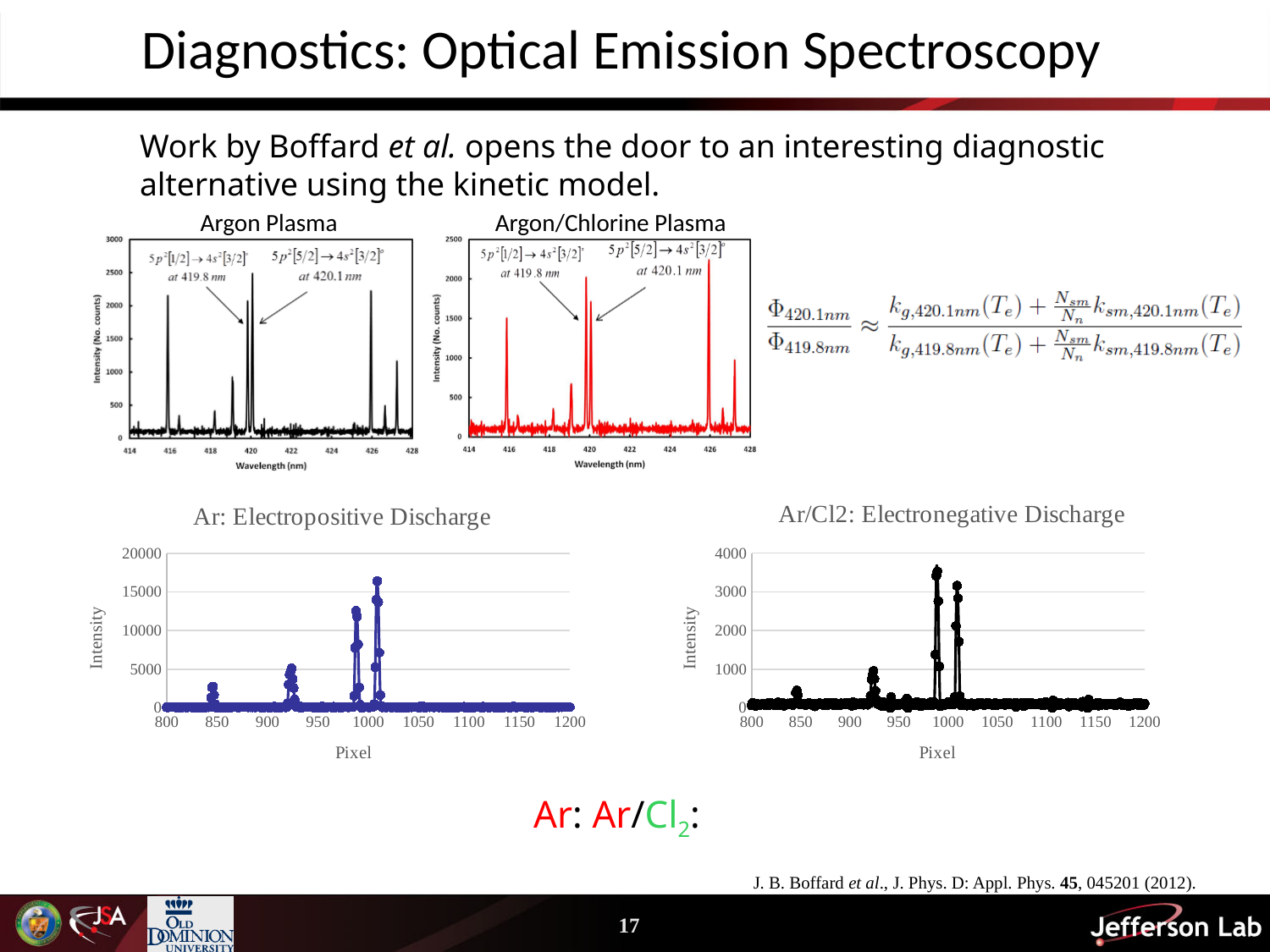
In the bottom-right chart 'Ar/Cl2: Electronegative Discharge', is the peak near pixel 850 greater or less than 1000? less In the top-left 'Argon Plasma' chart, at what wavelength does the annotation place the 5p²[1/2]→4s²[3/2] transition? 419.8 nm How many charts are shown on the slide? 4 In the top-left 'Argon Plasma' chart, which peak is taller: the one near 416 nm or the one near 420 nm? the one near 420 nm What kind of chart is the bottom-left chart titled 'Ar: Electropositive Discharge'? scatter chart In the top-right 'Argon/Chlorine Plasma' chart, is the tallest peak (near 426 nm) greater or less than 2000 counts? greater In the top-right 'Argon/Chlorine Plasma' chart, at what wavelength does the annotation place the 5p²[5/2]→4s²[3/2] transition? 420.1 nm What is the x-axis label of the bottom-left chart 'Ar: Electropositive Discharge'? Pixel In the bottom-right chart 'Ar/Cl2: Electronegative Discharge', is the tallest peak (near pixel 990) greater or less than 3000? greater In the bottom-left chart 'Ar: Electropositive Discharge', which peak is taller: the one near pixel 990 or the one near pixel 1010? the one near pixel 1010